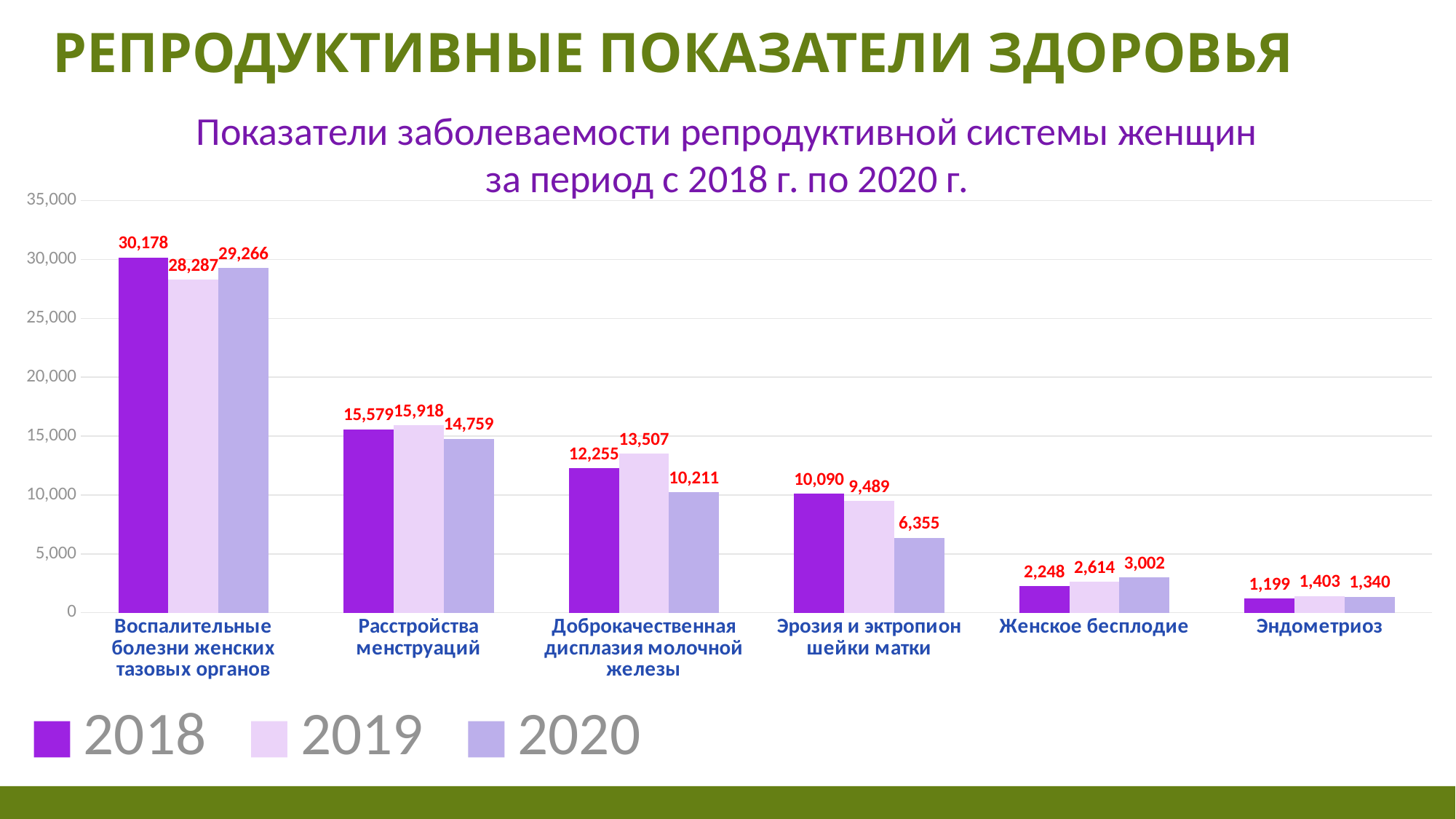
What is the difference between the 2018 and 2020 values for Воспалительные болезни женских тазовых органов? 912 How many categories are shown on the x axis? 6 Which is larger for Расстройства менструаций: the 2019 value or the 2020 value? 2019 What is the difference between the 2019 and 2020 values for Доброкачественная дисплазия молочной железы? 3,296 What kind of chart is shown on the slide? Bar chart What is the value for Эрозия и эктропион шейки матки in 2020? 6,355 What is the value for Воспалительные болезни женских тазовых органов in 2018? 30,178 Which category has the highest value in 2020? Воспалительные болезни женских тазовых органов What is the value for Женское бесплодие in 2019? 2,614 Which category has the lowest value in 2018? Эндометриоз How many series does the legend list? 3 Is the 2018 value for Эрозия и эктропион шейки матки greater or less than 10,000? greater